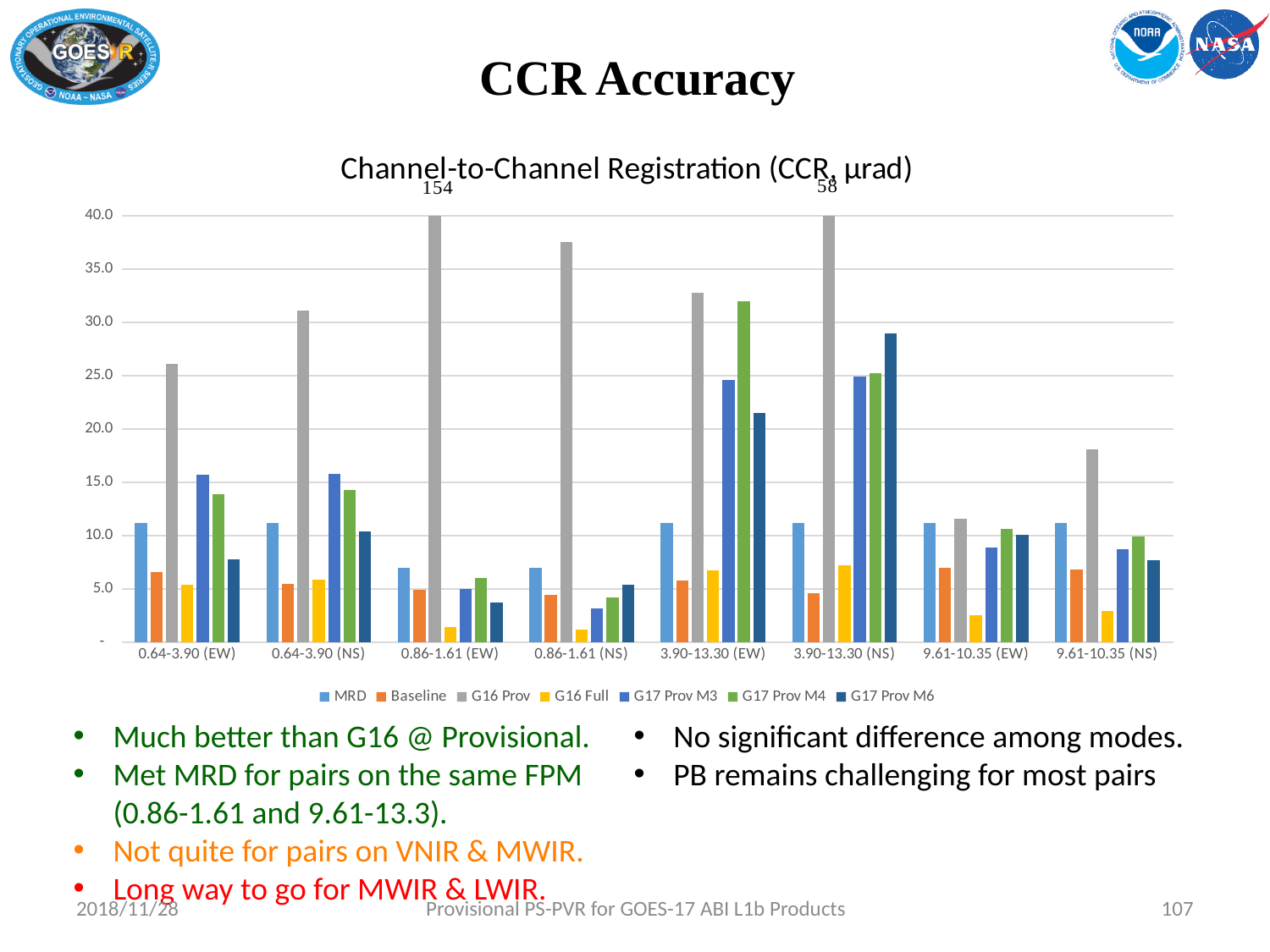
How many series does the chart legend list? 7 What is the title of the chart? Channel-to-Channel Registration (CCR, μrad) For 3.90-13.30 (EW), which is larger: G17 Prov M4 or G17 Prov M6? G17 Prov M4 What is the difference between the labelled G16 Prov values for 0.86-1.61 (EW) and 3.90-13.30 (NS)? 96 Is the G17 Prov M4 value for 3.90-13.30 (EW) greater or less than 30.0? greater What kind of chart is shown on the slide? bar chart What is the labelled value of the G16 Prov bar for 3.90-13.30 (NS)? 58 For which category is the G16 Prov value highest? 0.86-1.61 (EW) Which series has the lowest value for 0.86-1.61 (NS)? G16 Full How many categories are shown along the x axis of the chart? 8 Is the G16 Full value for 0.86-1.61 (EW) greater or less than 5.0? less What is the labelled value of the G16 Prov bar for 0.86-1.61 (EW)? 154